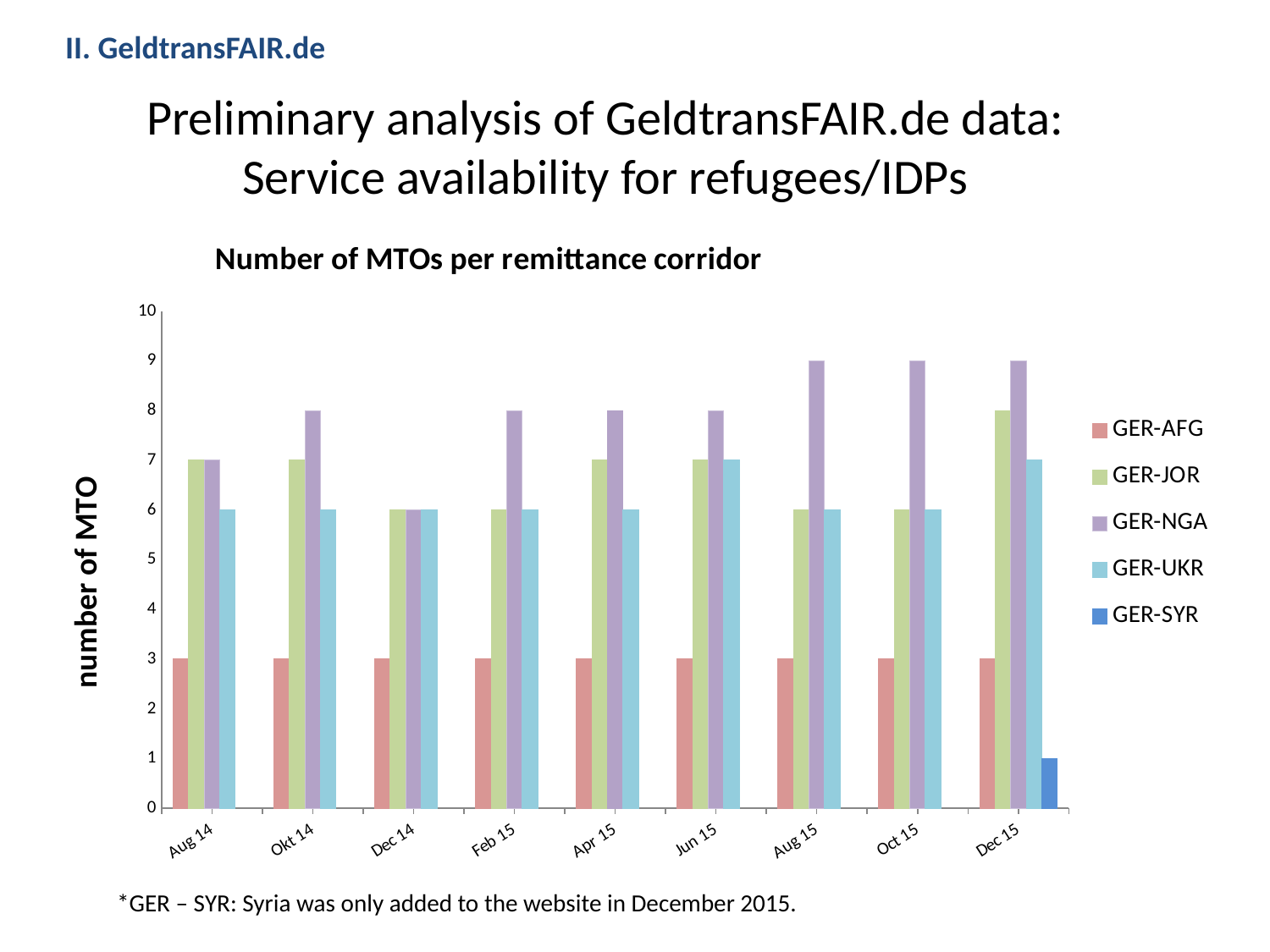
Which is larger in Okt 14, GER-NGA or GER-JOR? GER-NGA How many series does the legend list? 5 Which series has the lowest value in Dec 15? GER-SYR What is the difference between GER-NGA and GER-AFG in Oct 15? 6 Which series has the highest value in Aug 15? GER-NGA How many time periods are shown on the x axis? 9 What is the value for GER-SYR in Dec 15? 1 What kind of chart is shown on the slide? bar chart What is the value for GER-NGA in Dec 15? 9 What is the value for GER-JOR in Dec 15? 8 What is the title of the chart? Number of MTOs per remittance corridor What is the value for GER-AFG in Aug 14? 3